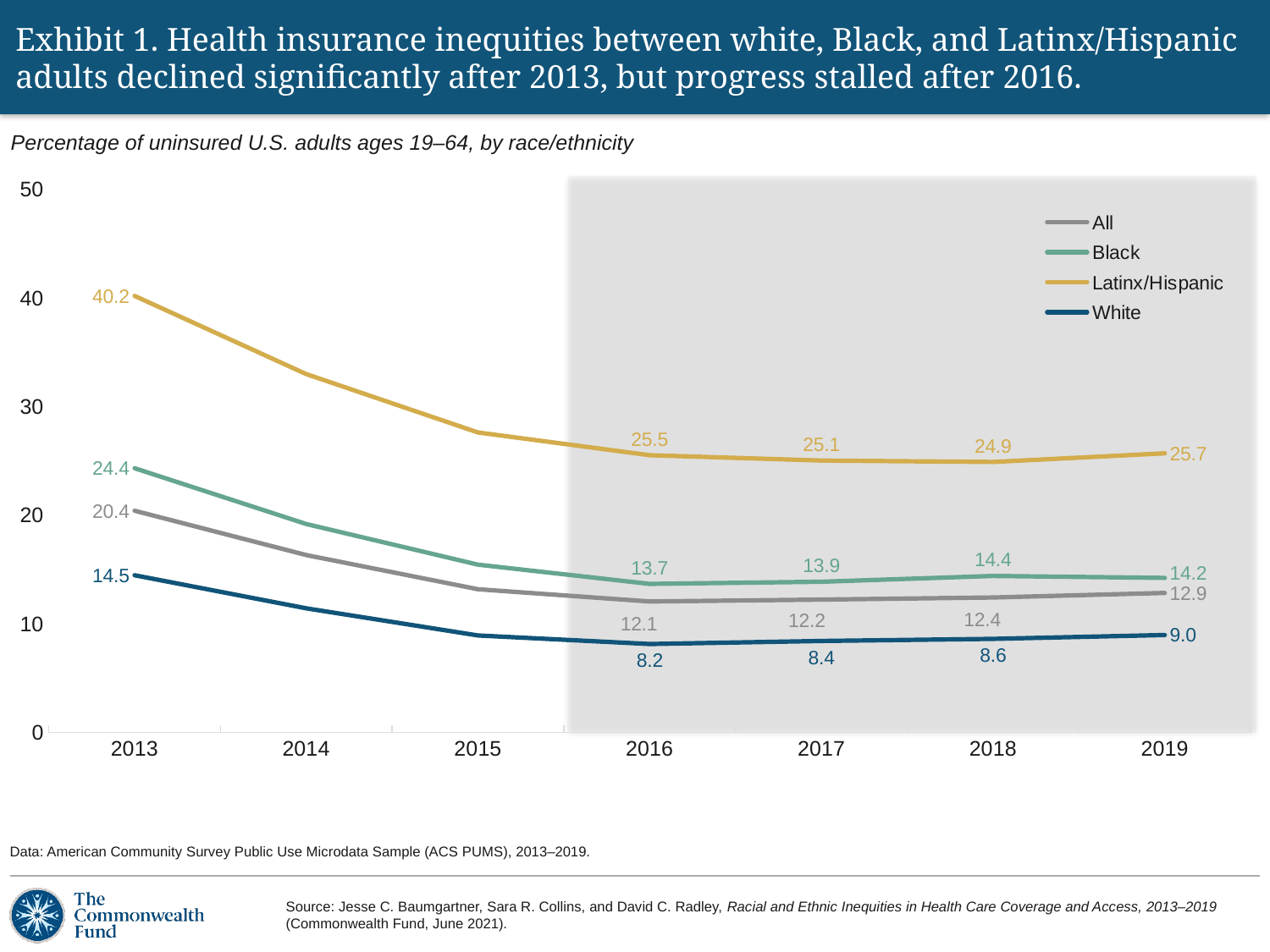
What was the percentage of uninsured Black adults in 2018? 14.4 How many series does the legend list? 4 Which group had the highest uninsured rate in 2019? Latinx/Hispanic Is the value for Latinx/Hispanic adults in 2015 greater or less than 30? less What was the value for the All series in 2016? 12.1 How many years are shown on the x axis? 7 What type of chart is shown on the slide? Line chart What was the percentage of uninsured Latinx/Hispanic adults in 2013? 40.2 What was the value for White adults in 2019? 9.0 Which group had the lowest uninsured rate in 2013? White By how much did the Latinx/Hispanic uninsured rate fall from 2013 to 2016? 14.7 How did the uninsured rate for White adults change from 2013 to 2016? It fell